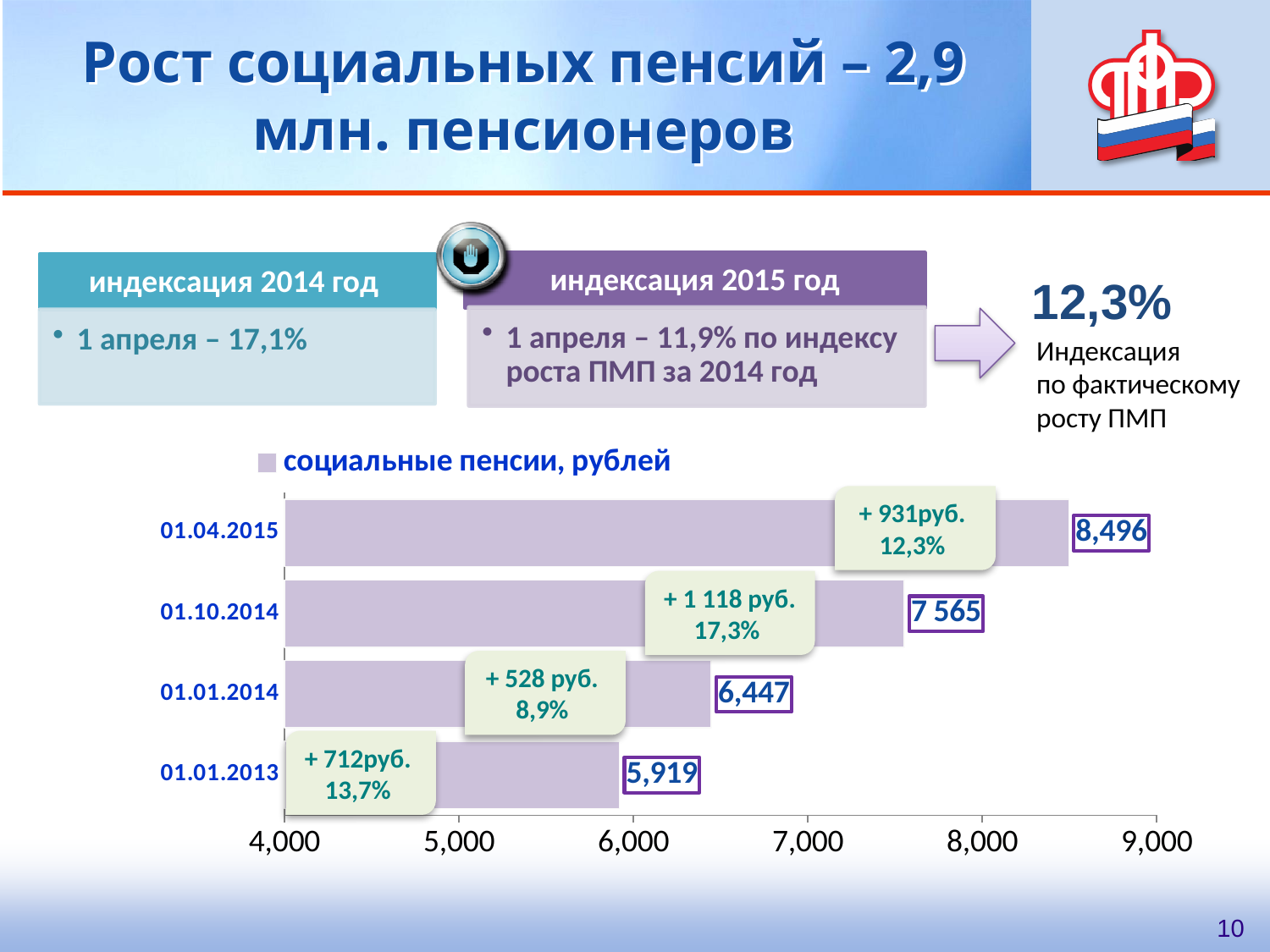
Which date has the lowest social pension value? 01.01.2013 How many dates (categories) are shown in the chart? 4 What is the value of the bar for 01.01.2014? 6,447 What type of chart is shown on the slide? bar chart Which is larger, the value for 01.10.2014 or the value for 01.01.2014? 01.10.2014 What is the value of the bar for 01.04.2015? 8,496 What is the value of the bar for 01.01.2013? 5,919 What is the legend entry of the chart? социальные пенсии, рублей What is the value of the bar for 01.10.2014? 7 565 Which date has the highest social pension value? 01.04.2015 What is the difference between the values for 01.04.2015 and 01.10.2014? 931 What is the difference between the values for 01.01.2014 and 01.01.2013? 528